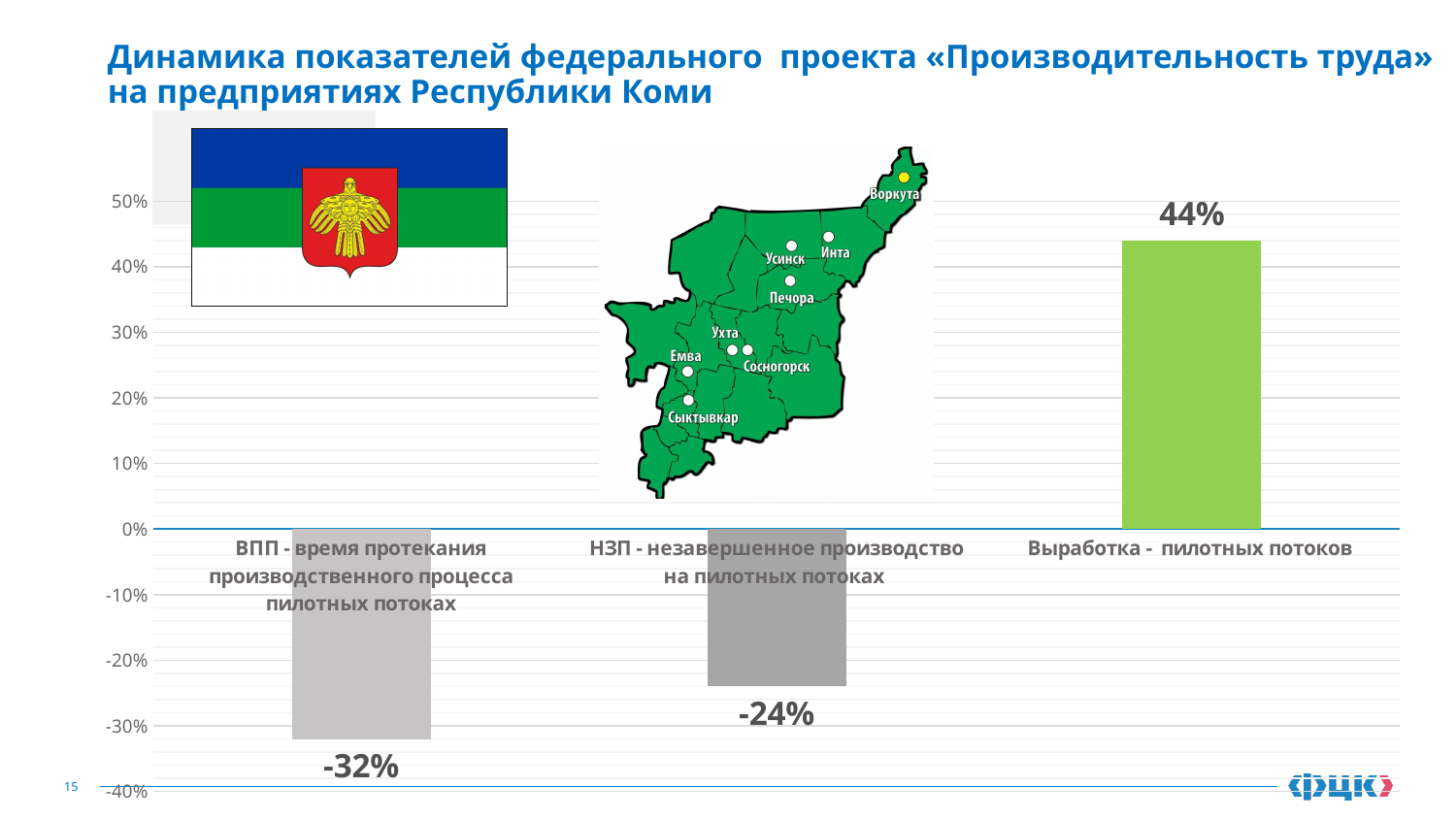
What kind of chart is shown on the slide? Bar chart Which category has the highest value? Выработка - пилотных потоков What is the value for «ВПП - время протекания производственного процесса пилотных потоках»? -32% Is the value for «Выработка - пилотных потоков» greater or less than 40%? greater Which is larger, the value for «ВПП» or the value for «НЗП»? НЗП How many of the bars have negative values? 2 What is the difference between the value for «Выработка» and the value for «НЗП»? 68 percentage points How many categories are shown in the chart? 3 What is the value for «НЗП - незавершенное производство на пилотных потоках»? -24% What is the value for «Выработка - пилотных потоков»? 44% Which category has the lowest value? ВПП - время протекания производственного процесса пилотных потоках What is the difference between the values for «ВПП» and «НЗП»? 8 percentage points